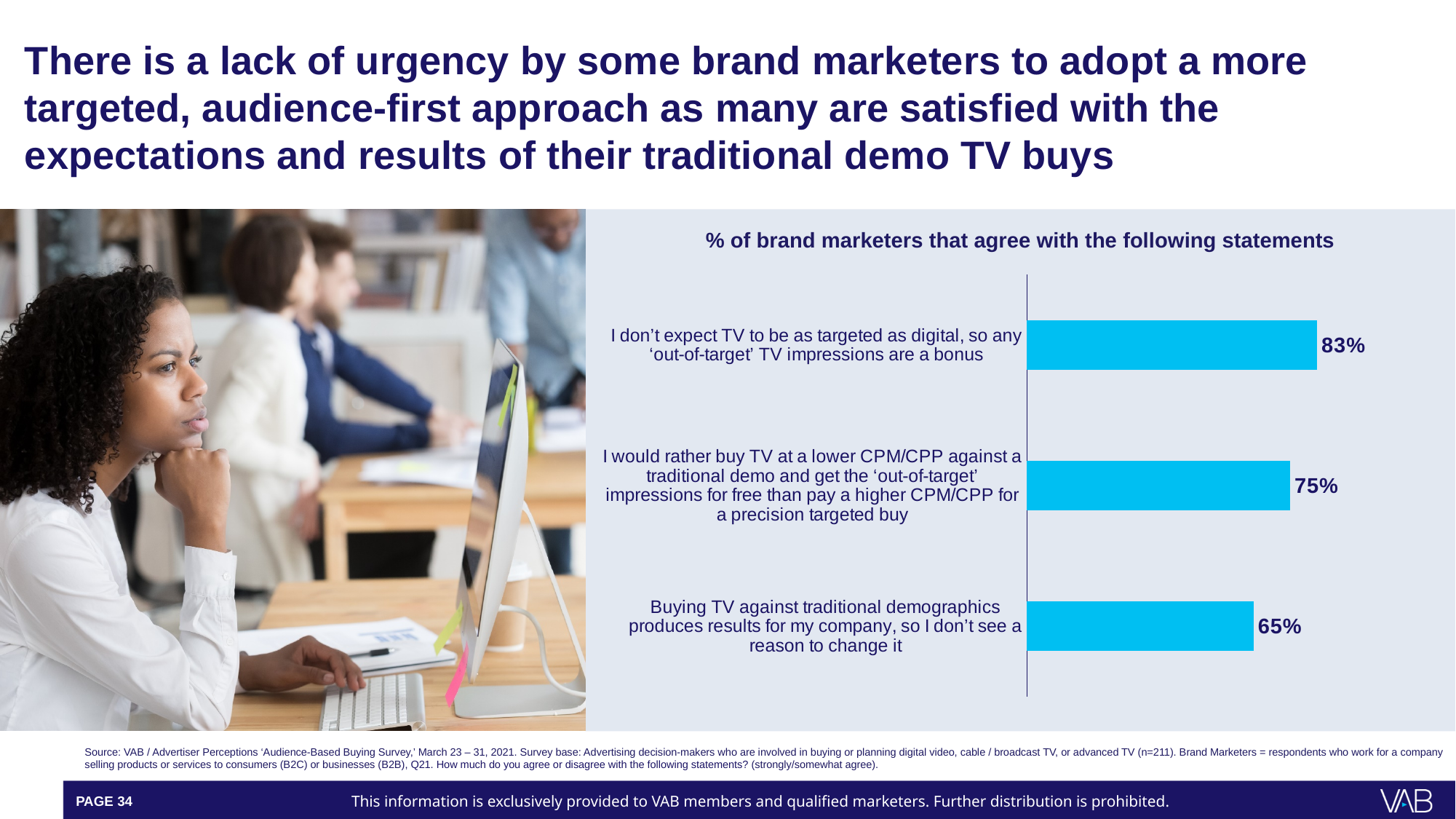
What is the title of the chart? % of brand marketers that agree with the following statements Which has a higher agreement rate: the lower CPM/CPP statement or the statement about buying TV against traditional demographics producing results? The lower CPM/CPP statement (75%) Which statement has the highest share of brand marketers agreeing with it? I don't expect TV to be as targeted as digital, so any 'out-of-target' TV impressions are a bonus Which statement has the lowest share of brand marketers agreeing with it? Buying TV against traditional demographics produces results for my company, so I don't see a reason to change it What colour are the bars in the chart? Light blue (cyan) What is the difference in percentage points between the highest and lowest agreement values shown in the chart? 18 percentage points What percentage of brand marketers agree that buying TV against traditional demographics produces results for their company, so they don't see a reason to change it? 65% What percentage of brand marketers agree that they would rather buy TV at a lower CPM/CPP against a traditional demo than pay a higher CPM/CPP for a precision targeted buy? 75% What percentage of brand marketers agree with the statement "I don't expect TV to be as targeted as digital, so any 'out-of-target' TV impressions are a bonus"? 83% How many statements are shown in the chart? 3 How many percentage points higher is agreement with the 'out-of-target' impressions are a bonus statement than with the lower CPM/CPP statement? 8 percentage points What type of chart is used on the slide? Bar chart